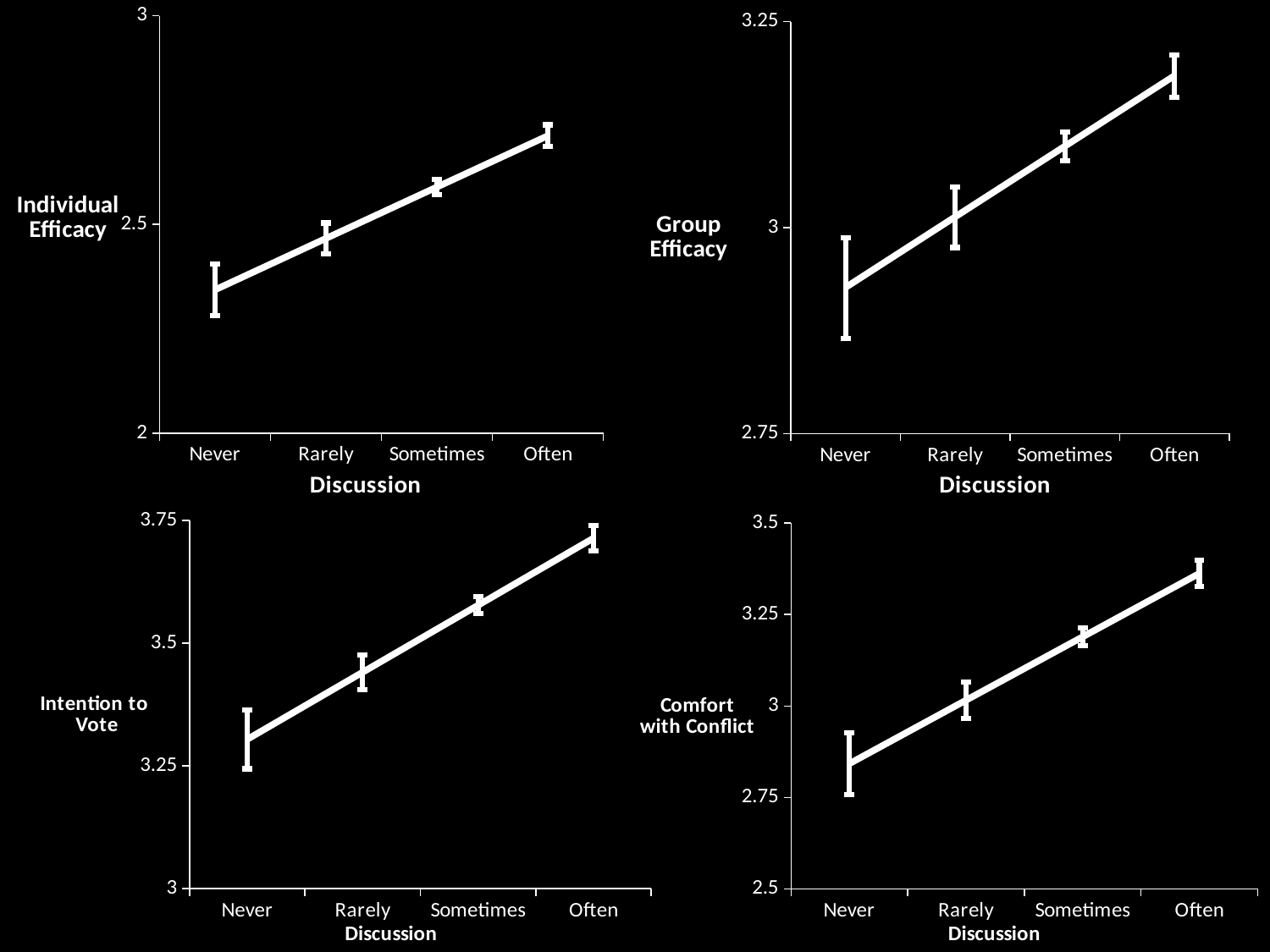
In the Individual Efficacy chart (top left), is the value for Never greater or less than 2.5? less In the Intention to Vote chart (bottom left), is the value for Sometimes greater or less than 3.5? greater What kind of chart is the Individual Efficacy chart (top left)? line chart In the Intention to Vote chart (bottom left), which discussion category has the highest value? Often How many categories are shown on the x axis of the Group Efficacy chart (top right)? 4 In the Comfort with Conflict chart (bottom right), which discussion category has the lowest value? Never In the Group Efficacy chart (top right), is the value for Never greater or less than 3? less What is the x-axis label shared by all four charts on the slide? Discussion In the Individual Efficacy chart (top left), do the values rise or fall from Never to Often? rise In the Group Efficacy chart (top right), which is larger, the value for Rarely or the value for Often? Often